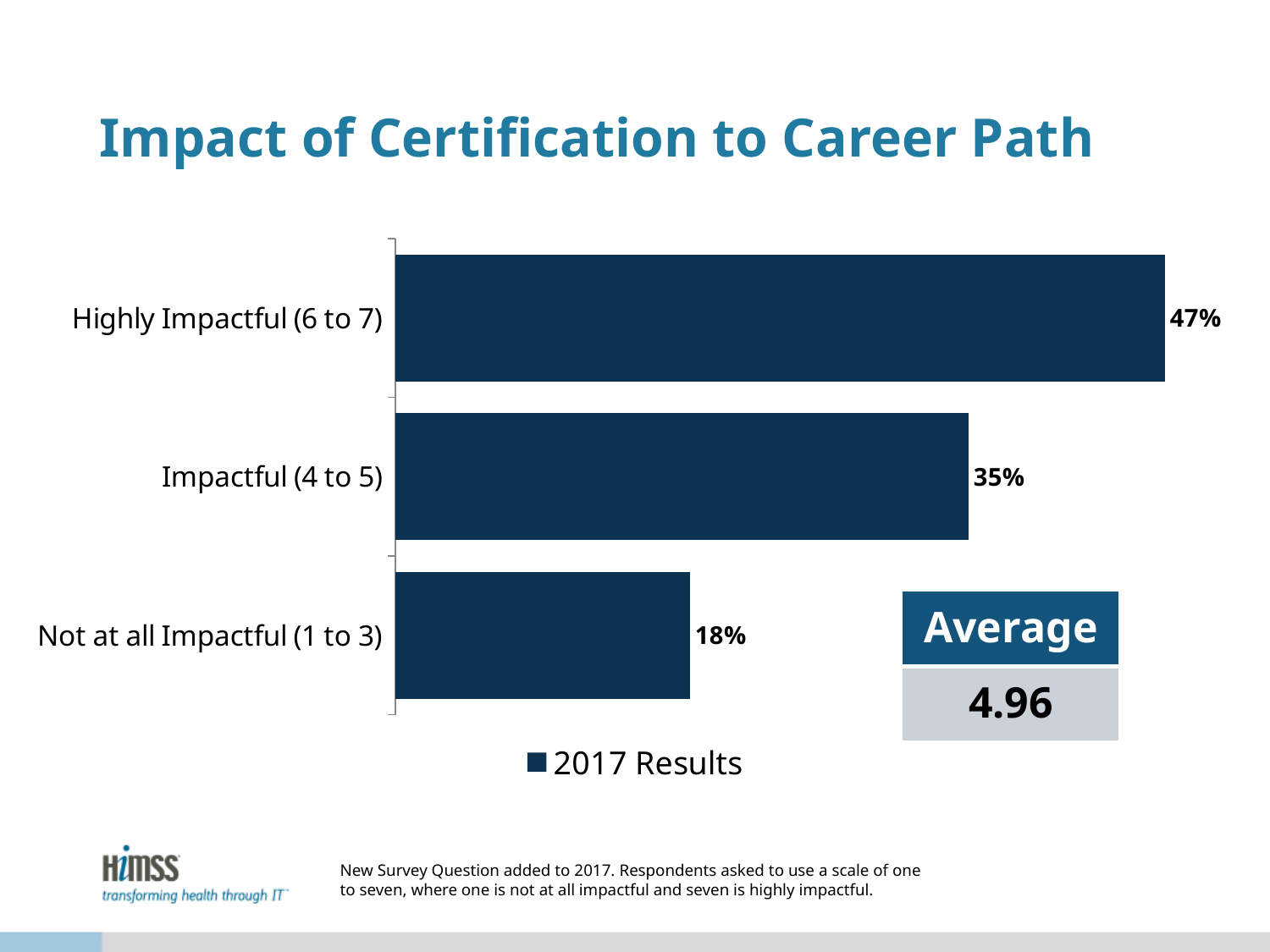
What is the value for Not at all Impactful (1 to 3)? 18% Which category has the lowest value? Not at all Impactful (1 to 3) What is the value for Impactful (4 to 5)? 35% How many categories are shown in the chart? 3 How many series does the legend list? 1 What average value is shown next to the chart? 4.96 What percentage of respondents rated certification as Highly Impactful (6 to 7)? 47% Which is larger, the value for Impactful (4 to 5) or Not at all Impactful (1 to 3)? Impactful (4 to 5) What is the difference between the Impactful (4 to 5) and Not at all Impactful (1 to 3) values? 17% What kind of chart is shown on the slide? Bar chart Which category has the highest value? Highly Impactful (6 to 7) What is the difference between the Highly Impactful (6 to 7) and Impactful (4 to 5) values? 12%